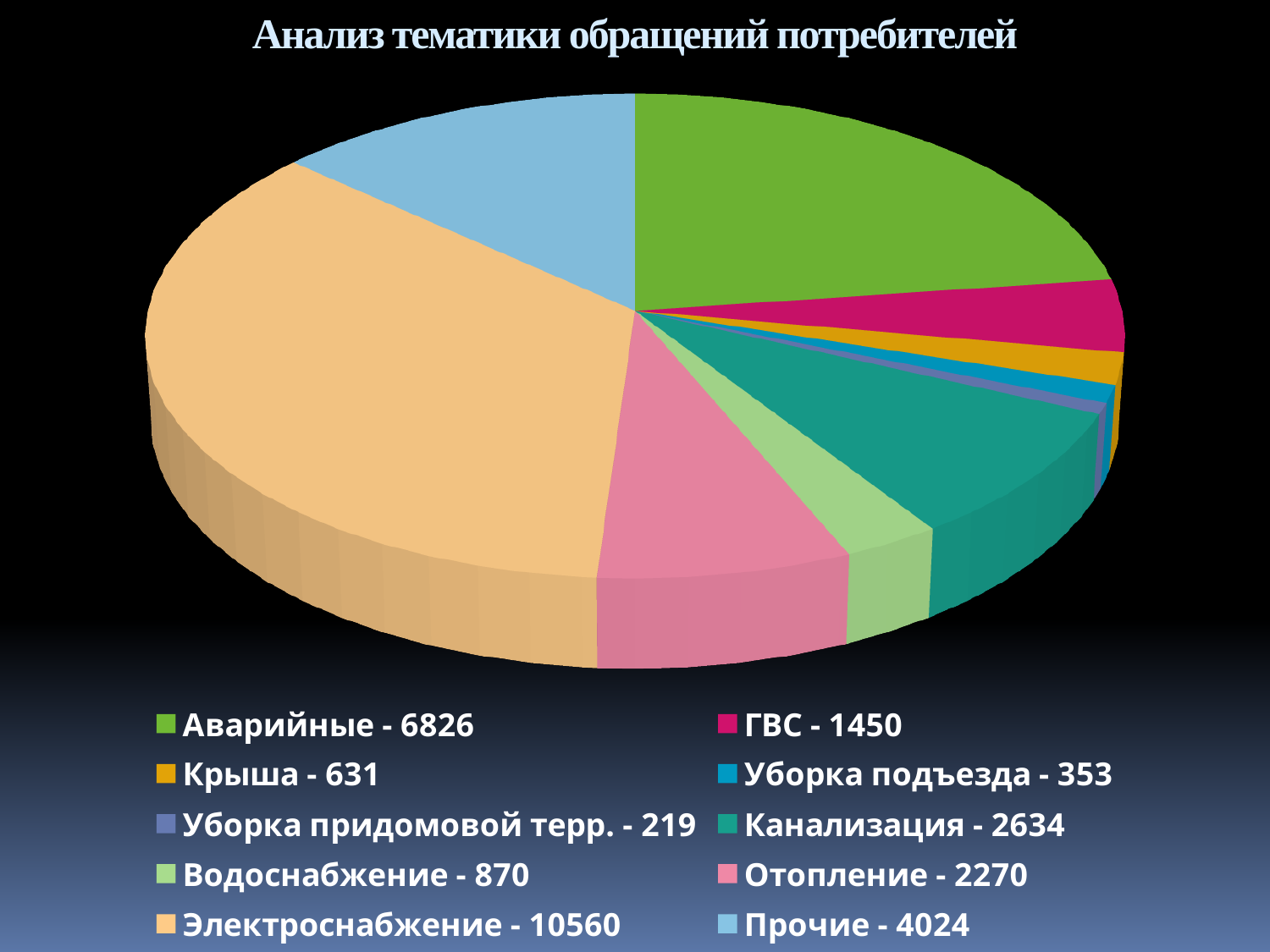
What is the value for Уборка подъезда? 353 What colour is the slice for Прочие? Light blue What is the title of the chart? Анализ тематики обращений потребителей What is the value for Канализация? 2634 What kind of chart is shown on the slide? Pie chart Which category has the smallest value? Уборка придомовой терр. What is the difference between the values for ГВС and Крыша? 819 Which category has the largest value? Электроснабжение What is the value for Электроснабжение? 10560 What is the difference between the values for Электроснабжение and Аварийные? 3734 Which is larger, the value for Канализация or the value for Отопление? Канализация How many categories does the pie chart have? 10